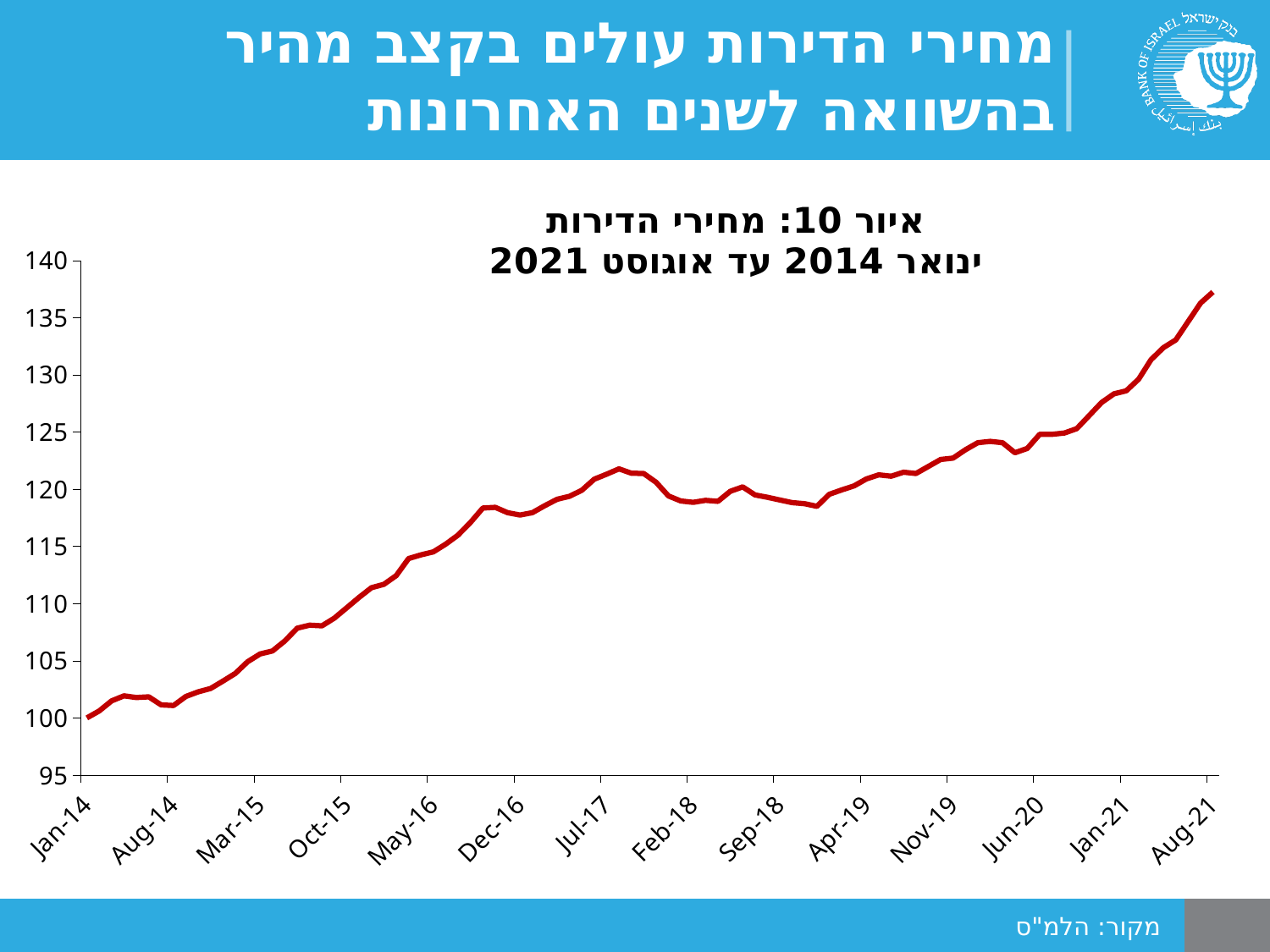
Is the value at Jul-17 greater or less than 120? greater What kind of chart is shown on the slide? line chart What is the value of the index at Jan-14? 100 At which x-axis label does the line reach its highest value? Aug-21 Which is larger, the value at Dec-16 or the value at Aug-14? Dec-16 What colour is the line in the chart? red Overall, do the values rise or fall from Jan-14 to Aug-21? rise How many date labels are shown on the x axis? 14 At which x-axis label is the line at its lowest value? Jan-14 Is the value at Aug-21 greater or less than 135? greater Is the value at Jan-21 greater or less than 125? greater